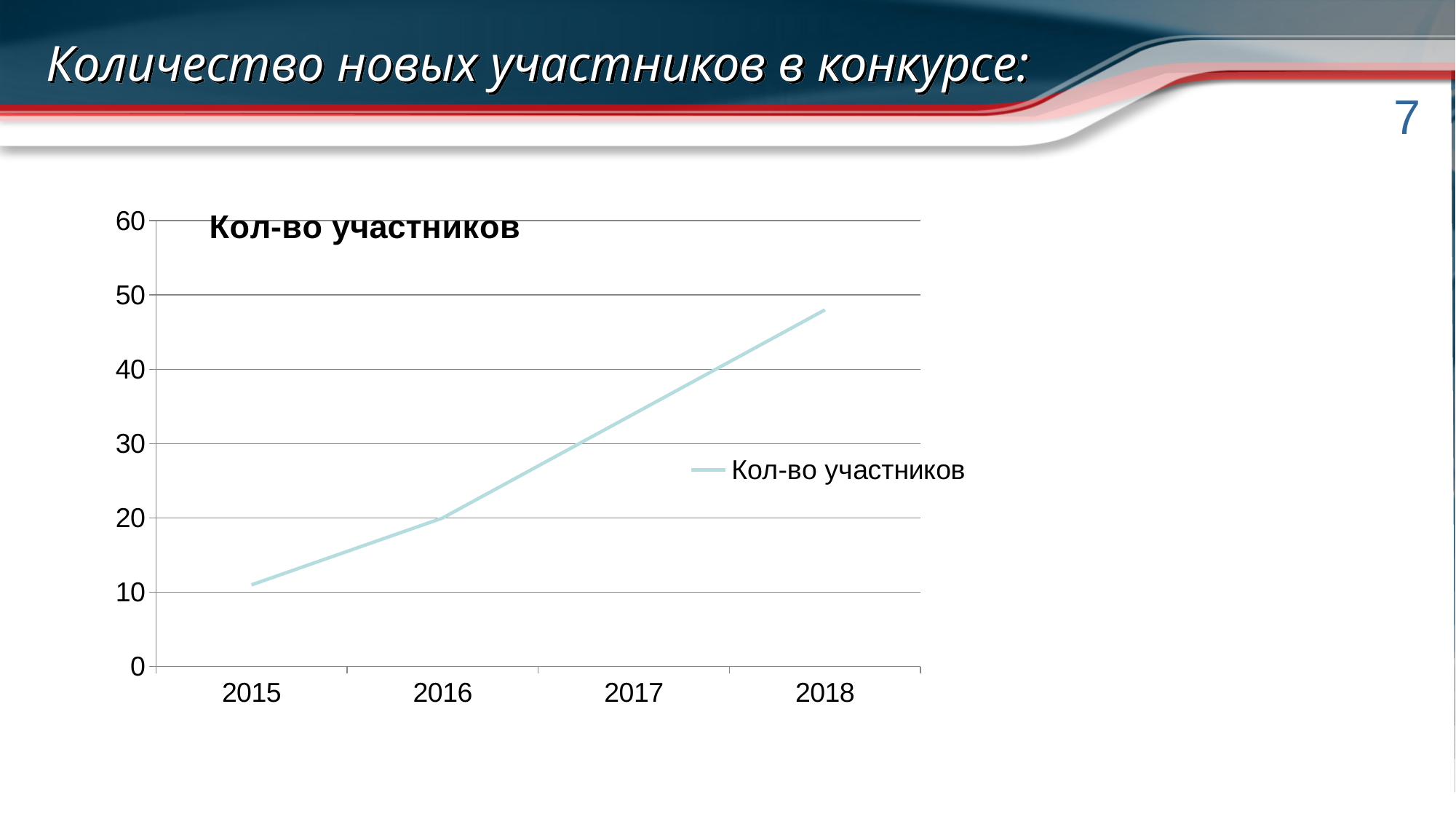
Which year has more participants, 2016 or 2018? 2018 Is the value for 2018 greater or less than 50? less How many series does the chart's legend list? 1 Is the value for 2015 greater or less than 20? less What kind of chart is shown on the slide? line chart Do the values rise or fall from 2015 to 2018? rise Which year has the highest number of participants? 2018 Which year has the lowest number of participants? 2015 Is the value for 2017 greater or less than 40? less What is the title of the chart? Кол-во участников How many years are plotted on the x axis of the chart? 4